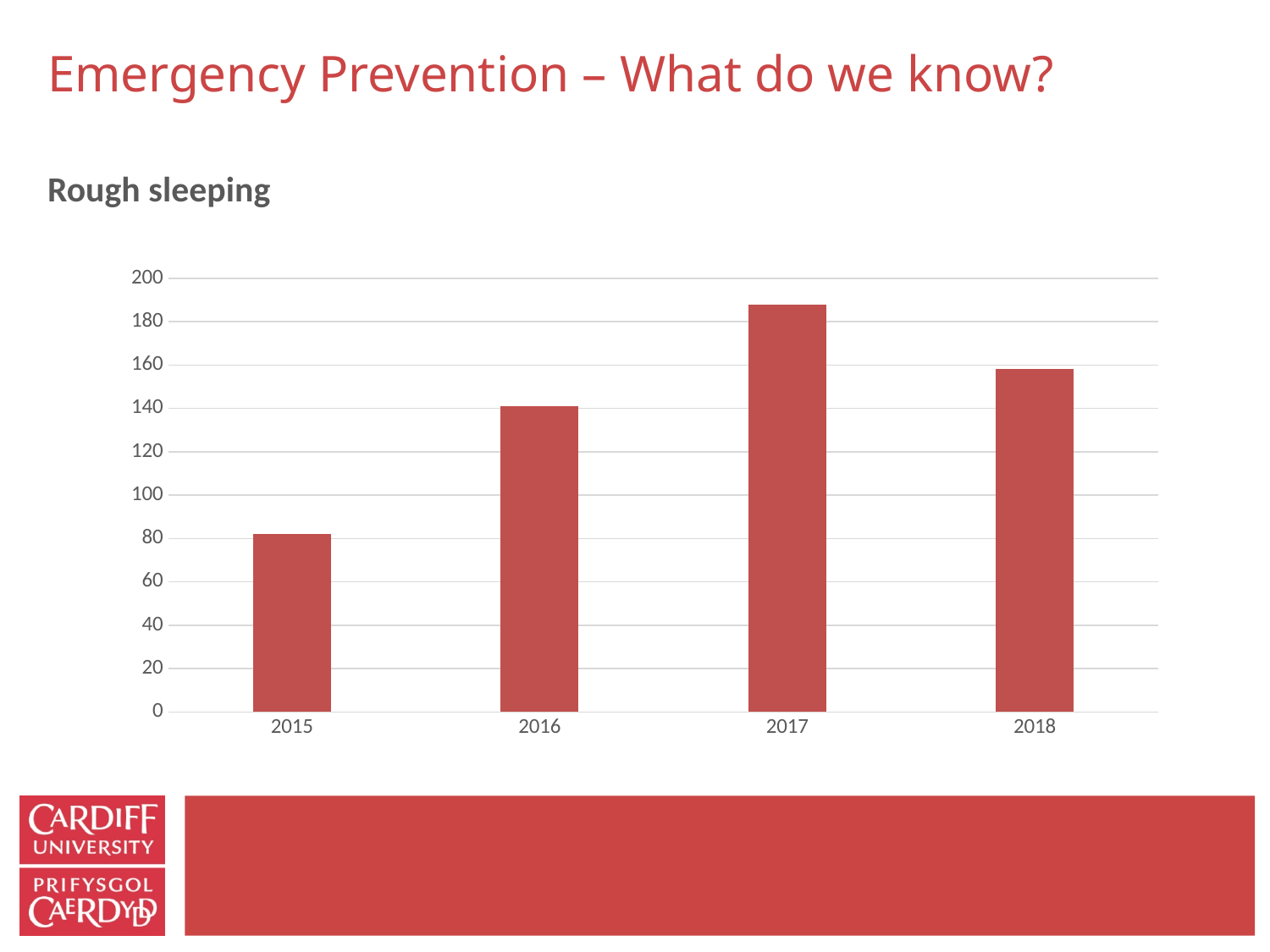
Which year has the lowest bar in the chart? 2015 Do the values rise or fall from 2015 to 2017? rise Which is larger, the value for 2016 or the value for 2018? 2018 Is the value for 2015 greater or less than 100? less What is the heading shown above the chart? Rough sleeping Do the values rise or fall from 2017 to 2018? fall Is the value for 2017 greater or less than 180? greater Is the value for 2018 greater or less than 140? greater How many years are shown on the x axis of the chart? 4 What kind of chart is shown on the slide? bar chart Which year has the highest bar in the chart? 2017